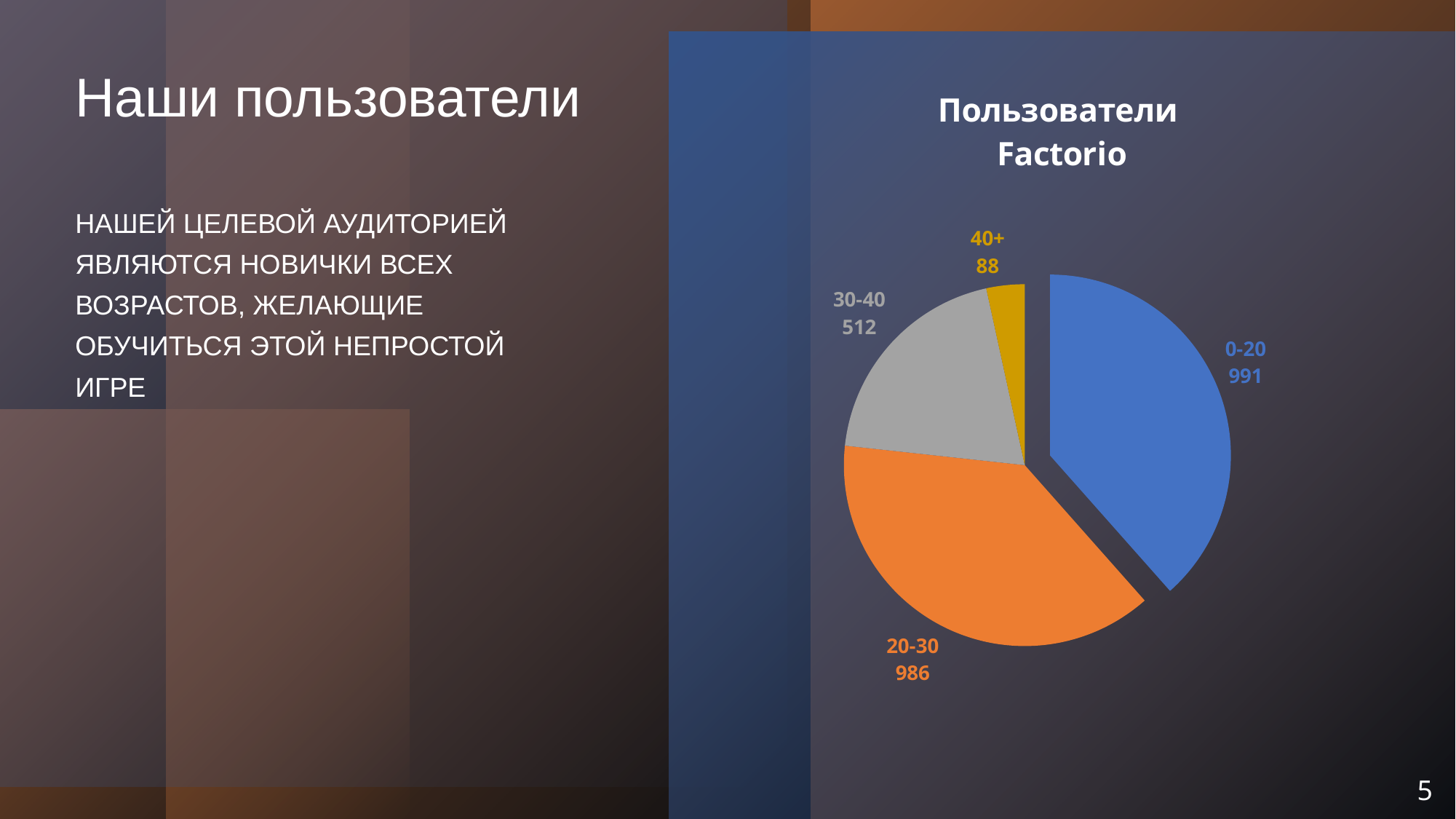
What is the value for the 20-30 age group? 986 What is the value for the 40+ age group? 88 What is the difference between the values for 20-30 and 30-40? 474 What is the value for the 0-20 age group? 991 How many slices does the pie chart have? 4 What is the title of the chart? Пользователи Factorio What colour is the slice for the 30-40 age group? grey Which age group has the smallest slice? 40+ What is the difference between the values for 0-20 and 40+? 903 Which is larger, the value for 20-30 or the value for 30-40? 20-30 What kind of chart is shown on the slide? pie chart What is the value for the 30-40 age group? 512